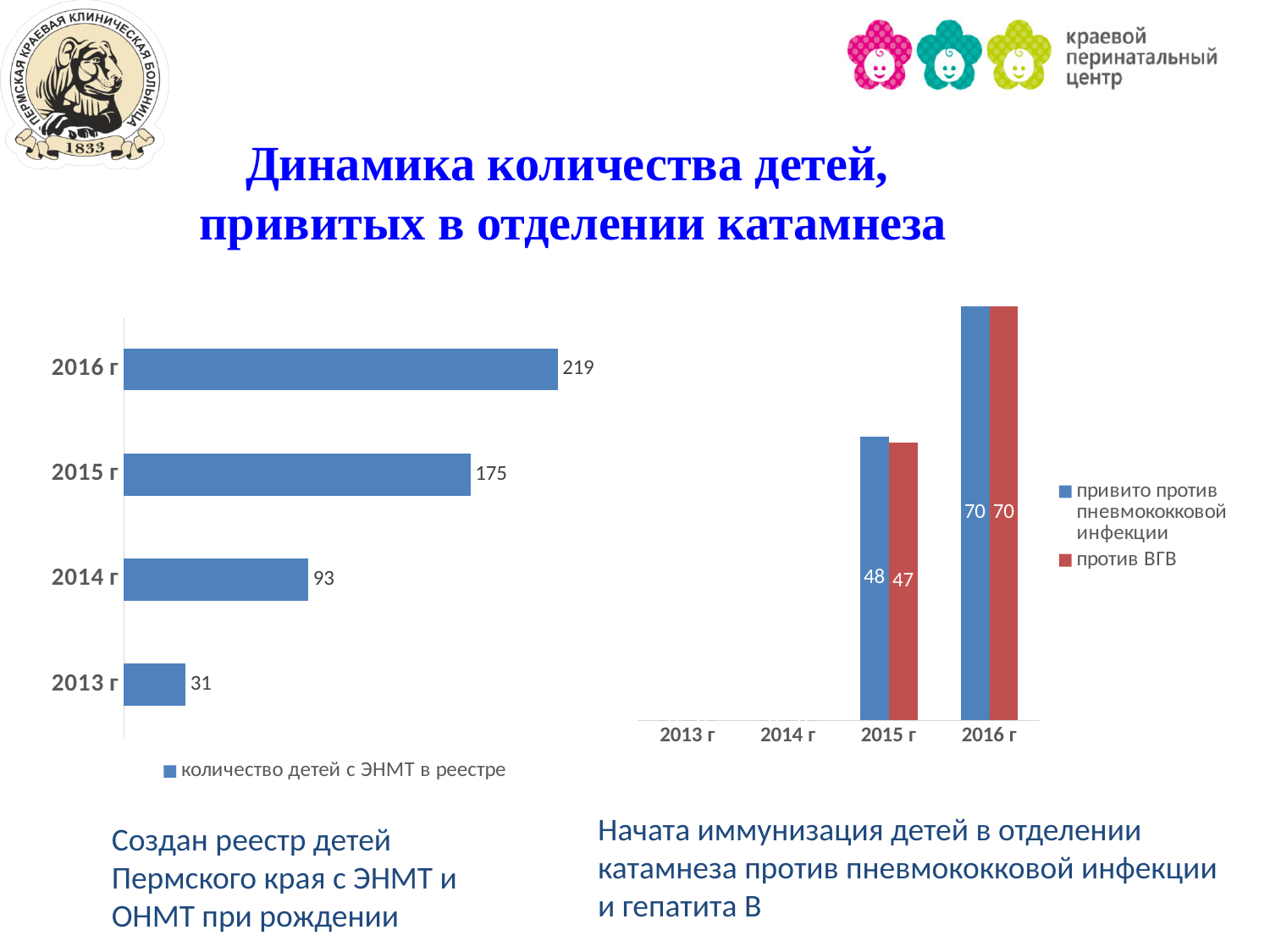
In the right chart, what is the value for привито против пневмококковой инфекции in 2015 г? 48 In the left chart (количество детей с ЭНМТ в реестре), do the values rise or fall from 2013 г to 2016 г? rise In the left chart (количество детей с ЭНМТ в реестре), what is the difference between the values for 2015 г and 2014 г? 82 In the left chart (количество детей с ЭНМТ в реестре), what is the value for 2013 г? 31 In the left chart (количество детей с ЭНМТ в реестре), what is the value for 2016 г? 219 In the right chart, what is the value for против ВГВ in 2016 г? 70 In the right chart, how many series does the legend list? 2 In the right chart, which is larger in 2015 г: привито против пневмококковой инфекции or против ВГВ? привито против пневмококковой инфекции In the left chart (количество детей с ЭНМТ в реестре), which year has the lowest value? 2013 г In the left chart (количество детей с ЭНМТ в реестре), how many years are shown? 4 What kind of chart is the left chart (количество детей с ЭНМТ в реестре)? bar chart In the left chart (количество детей с ЭНМТ в реестре), which year has the highest value? 2016 г